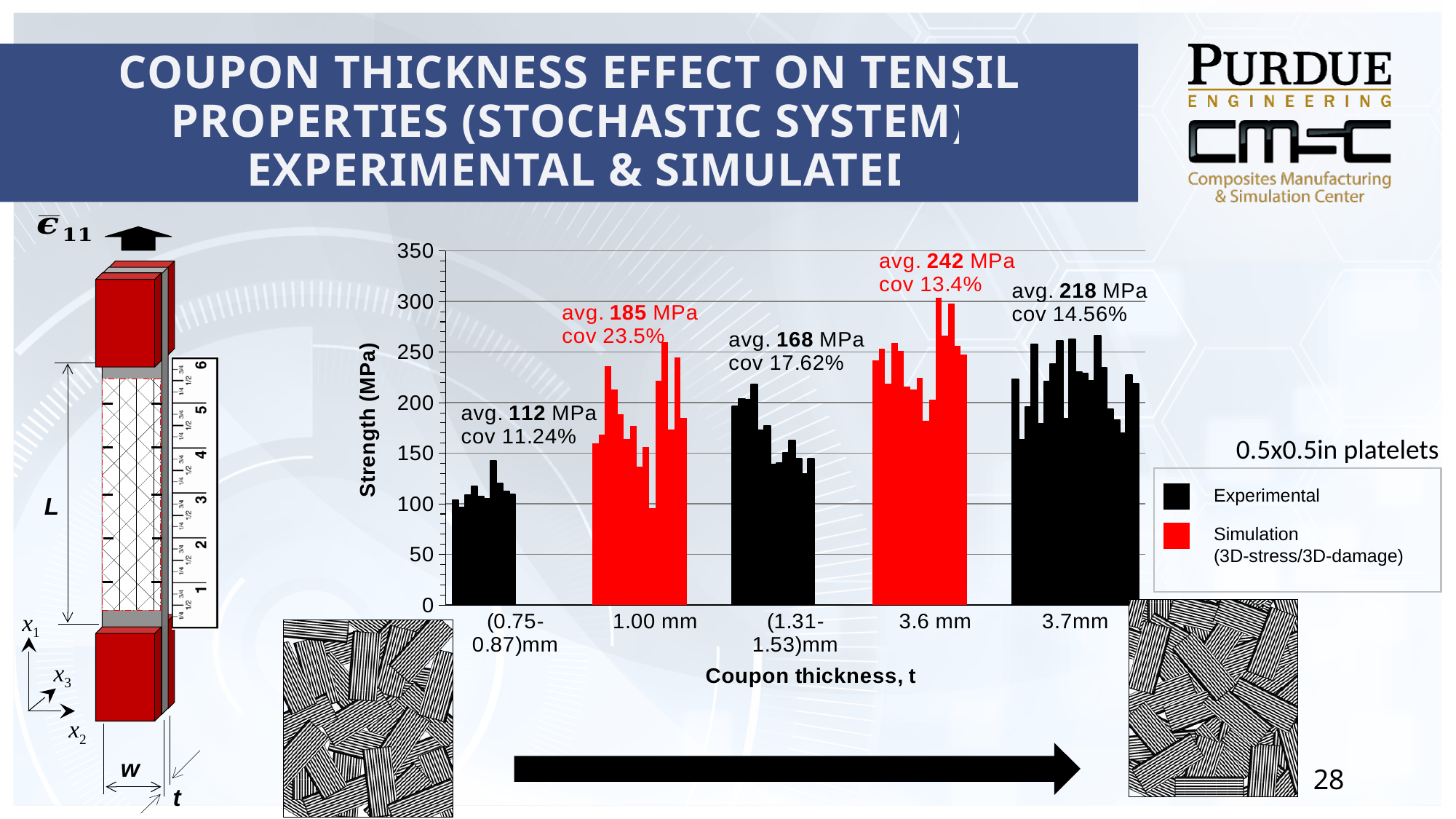
Which coupon thickness group has the highest annotated average strength? 3.6 mm What is the title of the y axis of the chart? Strength (MPa) What kind of chart is shown on the slide? Bar chart Which coupon thickness group has the lowest annotated average strength? (0.75-0.87)mm How many series does the legend list? 2 Which has a higher annotated average strength, the 1.00 mm group or the (1.31-1.53)mm group? 1.00 mm What is the average strength annotated for the 3.6 mm coupon thickness group? 242 MPa What is the difference between the annotated average strengths of the 3.6 mm and 3.7mm groups? 24 MPa What coefficient of variation (cov) is annotated for the 1.00 mm group? 23.5% What coefficient of variation (cov) is annotated for the 3.7mm group? 14.56% How many coupon thickness groups are shown on the x axis? 5 What is the average strength annotated for the (0.75-0.87)mm coupon thickness group? 112 MPa